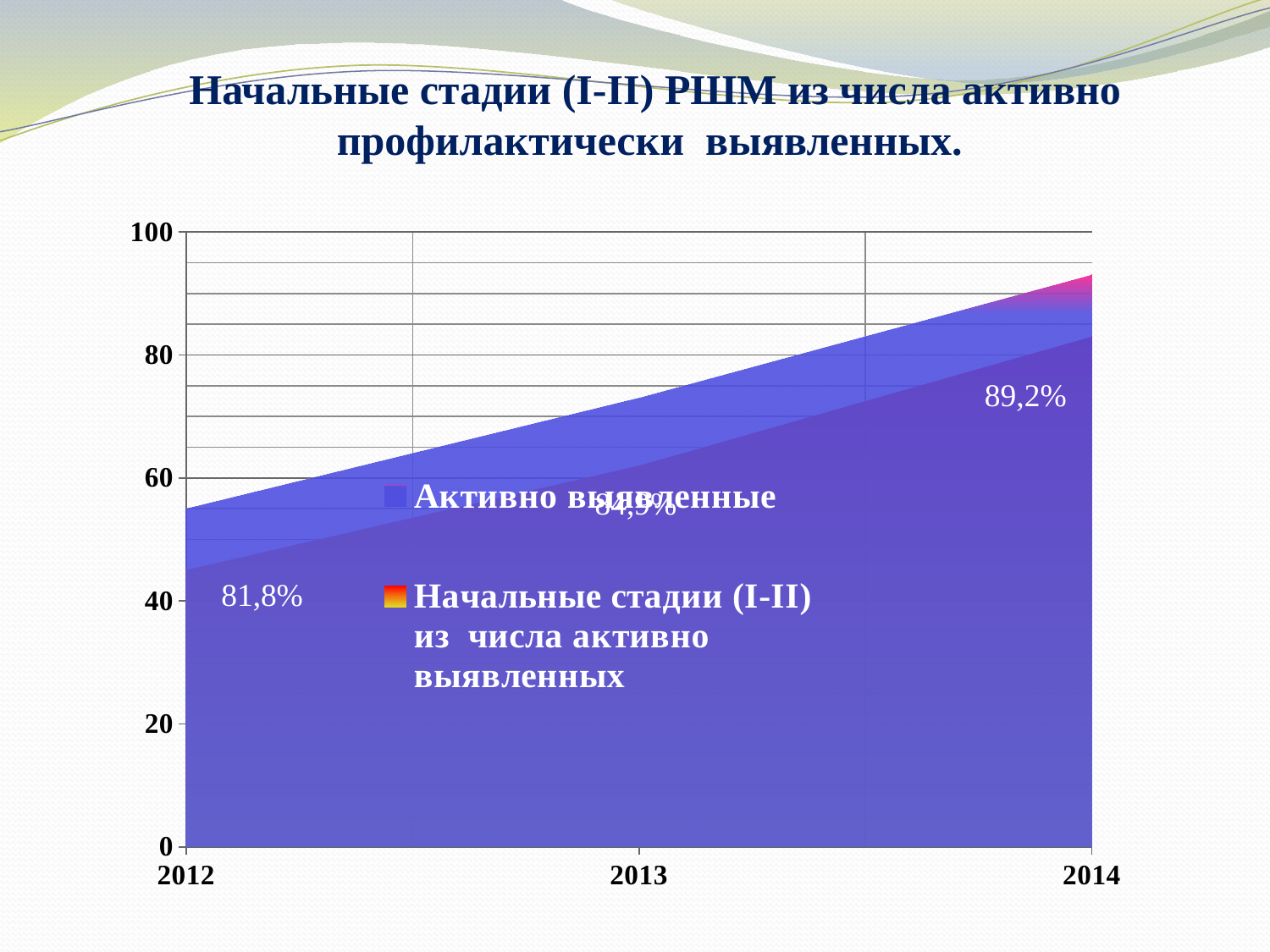
How many series does the chart legend list? 2 How many years are shown on the x axis of the chart? 3 By how much does the labelled value for 2014 exceed the labelled value for 2012? 7,4% What kind of chart is shown on the slide? Area chart Which year has the larger labelled value, 2012 or 2014? 2014 What is the data label shown for 2014? 89,2% What is the title of the slide? Начальные стадии (I-II) РШМ из числа активно профилактически выявленных. What is the data label shown for 2012? 81,8% What is the first series listed in the chart legend? Активно выявленные Which year has the lowest labelled value? 2012 Which year has the highest labelled value? 2014 Do the labelled values rise or fall from 2012 to 2014? Rise